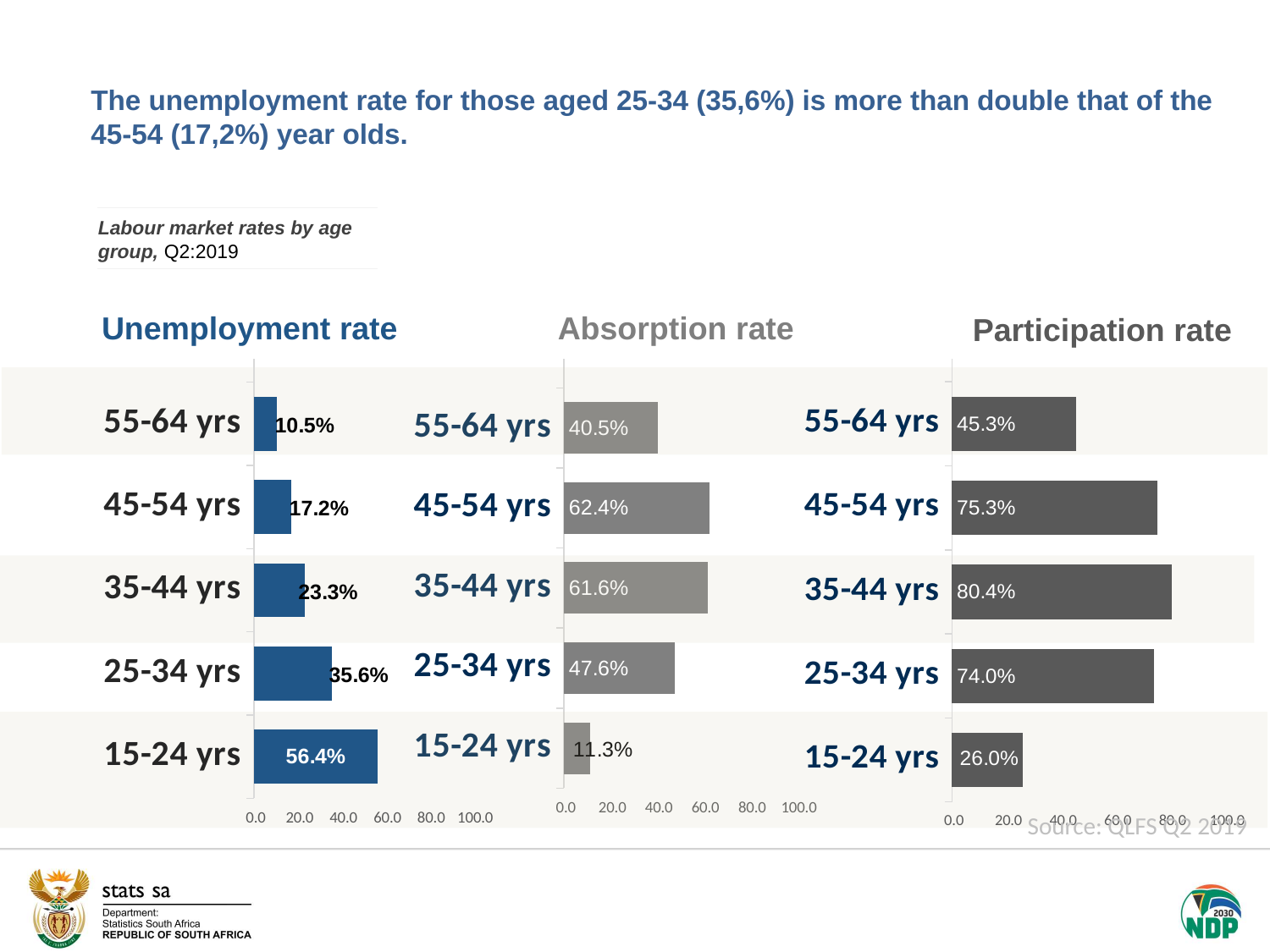
In the Unemployment rate chart, what is the difference between the values for 25-34 yrs and 45-54 yrs? 18.4% In the Participation rate chart, what is the value for 35-44 yrs? 80.4% What is the title of the leftmost chart on the slide? Unemployment rate In the Absorption rate chart, is the value for 15-24 yrs greater or less than 20.0? less In the Absorption rate chart, what is the value for 45-54 yrs? 62.4% In the Unemployment rate chart, what is the value for 15-24 yrs? 56.4% How many age groups are shown in the Unemployment rate chart? 5 In the Unemployment rate chart, which age group has the lowest value? 55-64 yrs In the Participation rate chart, which age group has the lowest value? 15-24 yrs In the Absorption rate chart, which age group has the highest value? 45-54 yrs In the Participation rate chart, which is larger: the value for 45-54 yrs or 25-34 yrs? 45-54 yrs What kind of chart is the Participation rate chart? Bar chart